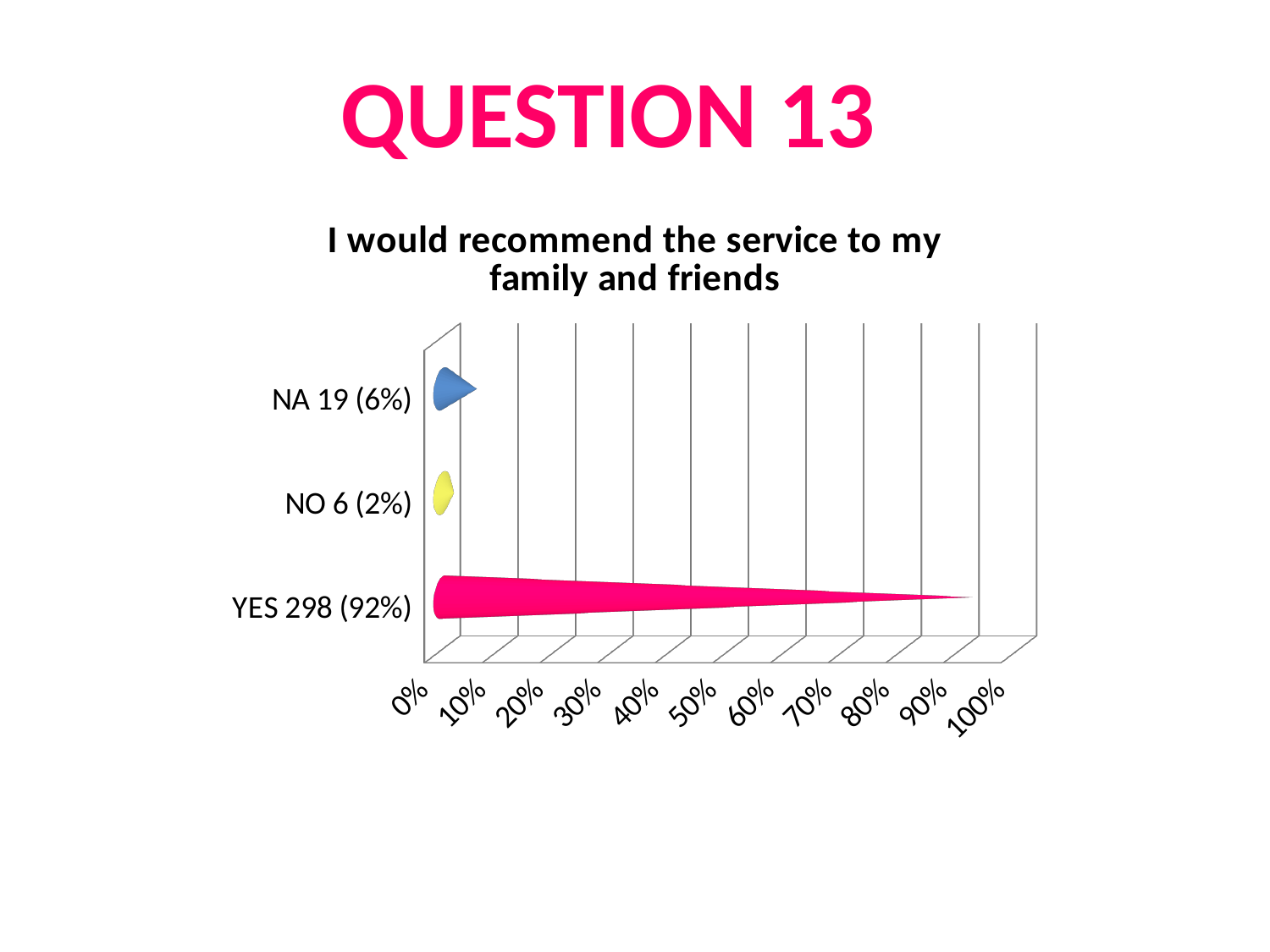
Which category has the highest value? YES What percentage of respondents answered NO? 2% What percentage of respondents answered NA? 6% Is the value for YES greater or less than 90%? greater What is the difference in percentage points between YES and NA? 86 How many respondents answered NA? 19 What kind of chart is shown on the slide? bar chart What percentage of respondents answered YES? 92% Which category has the lowest value? NO How many categories does the chart show? 3 How many respondents answered YES? 298 What is the title of the chart? I would recommend the service to my family and friends